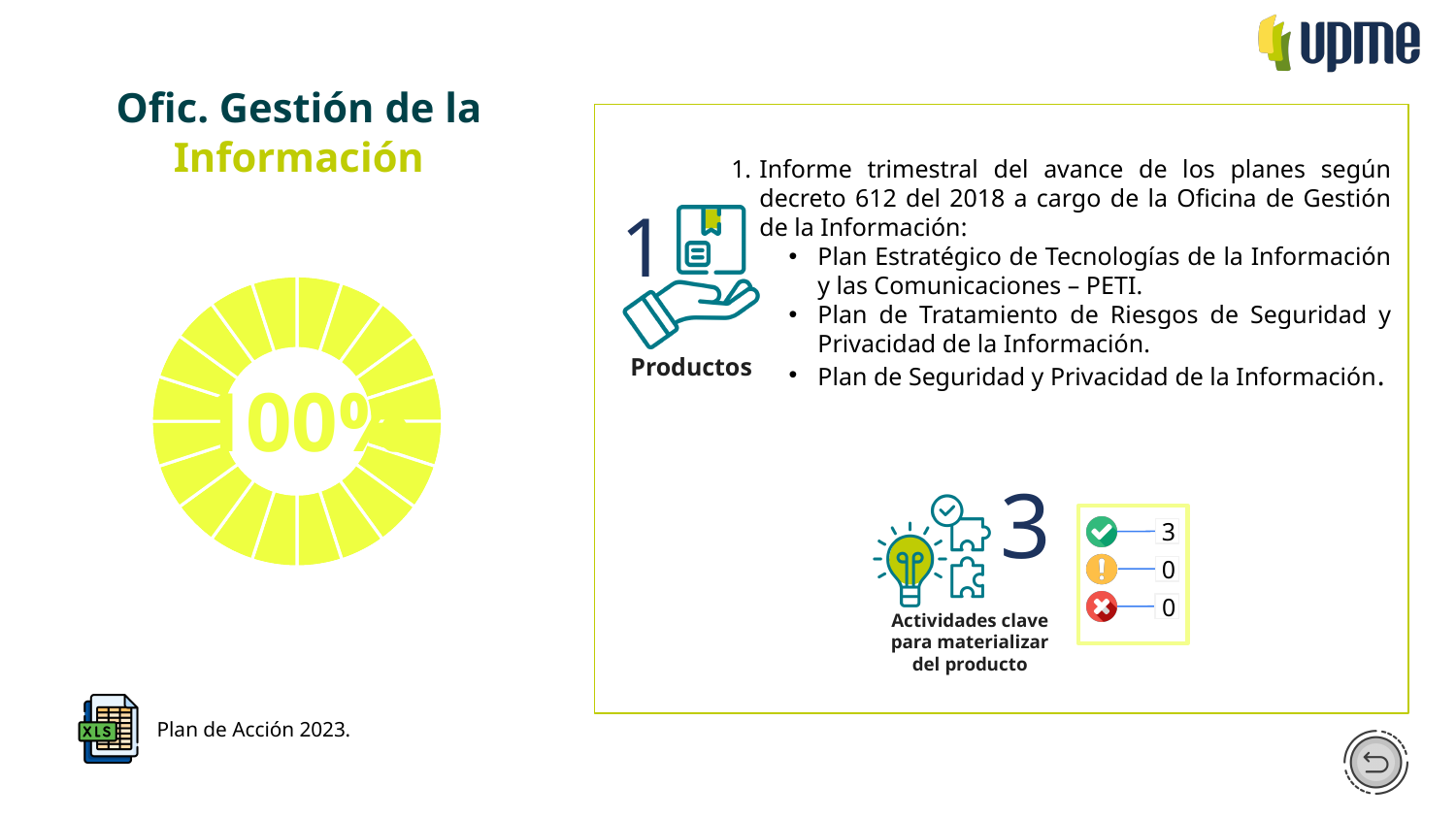
What kind of chart is shown on the left side of the slide? doughnut chart What colour are the segments of the doughnut chart? yellow What is the total of the three counts shown in the status box? 3 What value is printed in the centre of the doughnut chart? 00% In the status box, which icon has the highest count: green check, yellow exclamation, or red X? green check In the status box next to 'Actividades clave para materializar del producto', what number is shown beside the green check icon? 3 In the status box next to 'Actividades clave para materializar del producto', what number is shown beside the yellow exclamation icon? 0 In the status box next to 'Actividades clave para materializar del producto', what number is shown beside the red X icon? 0 How many 'Actividades clave' are indicated by the large number next to the light bulb icon? 3 How many 'Productos' are indicated by the large number next to the hand icon? 1